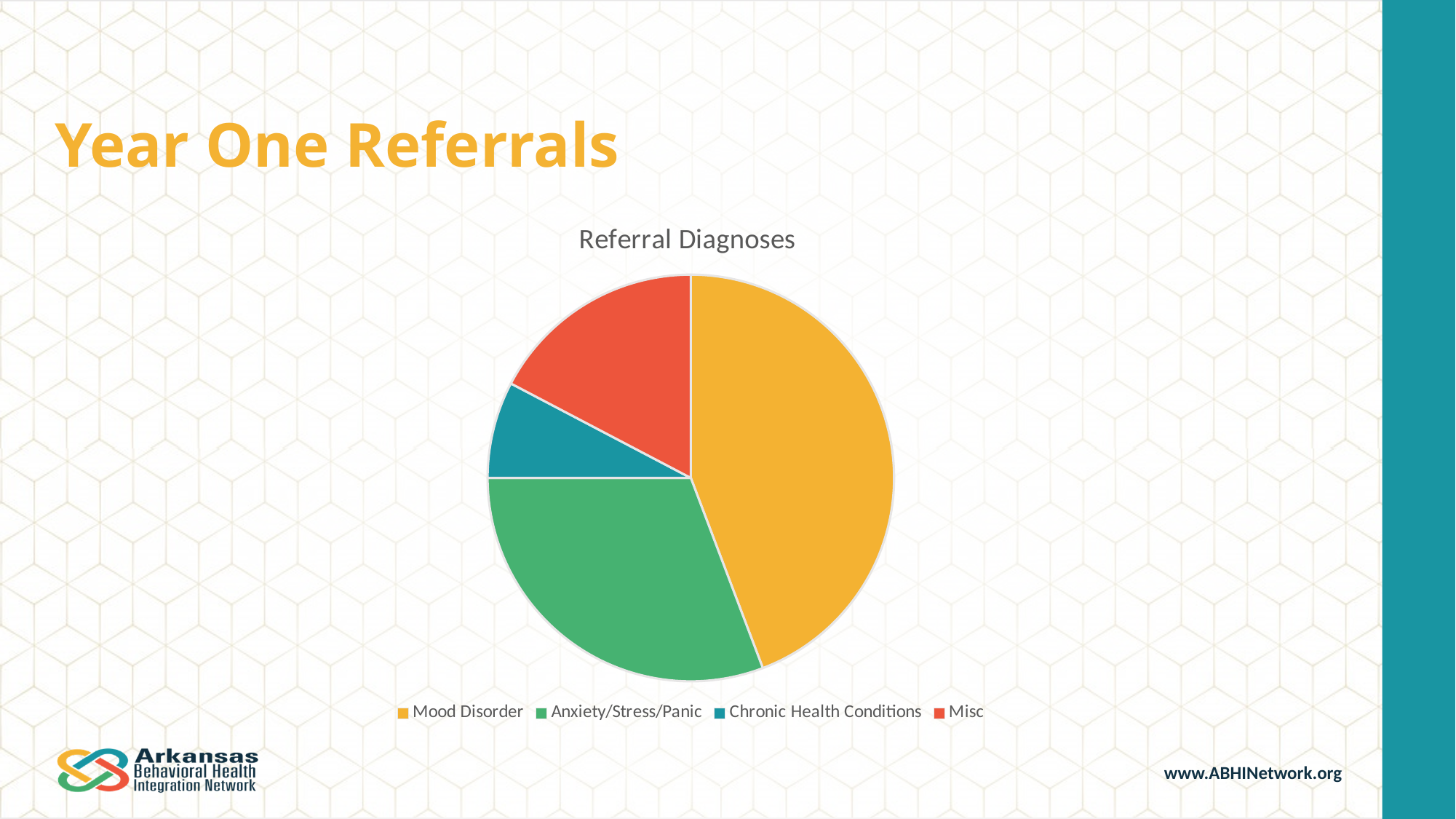
Which slice is larger: Anxiety/Stress/Panic or Misc? Anxiety/Stress/Panic Which category has the largest slice of the pie? Mood Disorder Which category has the second-largest slice of the pie? Anxiety/Stress/Panic What kind of chart is shown on the slide? Pie chart Which slice is larger: Misc or Chronic Health Conditions? Misc Which category has the smallest slice of the pie? Chronic Health Conditions What is the title of the chart? Referral Diagnoses Which category is shown in green in the pie chart? Anxiety/Stress/Panic How many categories (slices) does the pie chart have? 4 Which slice is larger: Mood Disorder or Anxiety/Stress/Panic? Mood Disorder